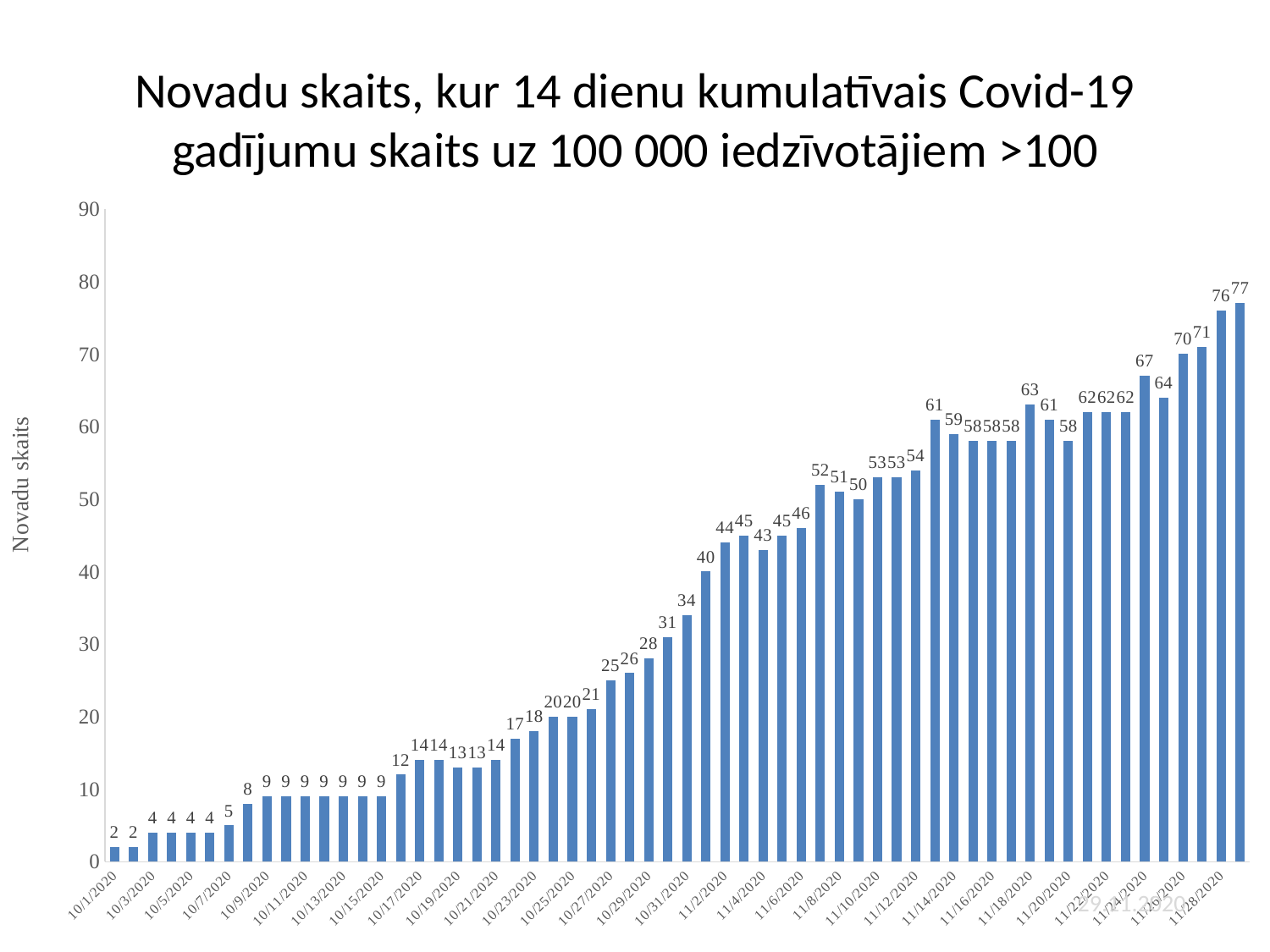
Do the values generally rise or fall from left to right along the x axis? rise What is the value for 10/1/2020? 2 Is the value for 11/2/2020 greater or less than 40? greater What is the highest value shown in the chart? 77 What is the value for 11/28/2020? 76 What is the value for 11/18/2020? 63 What is the difference between the values for 11/24/2020 and 10/27/2020? 42 What is the label of the vertical axis? Novadu skaits Which is larger, the value for 11/14/2020 or the value for 11/16/2020? 11/14/2020 What is the lowest value shown in the chart? 2 What is the value for 10/31/2020? 34 What type of chart is shown on the slide? bar chart